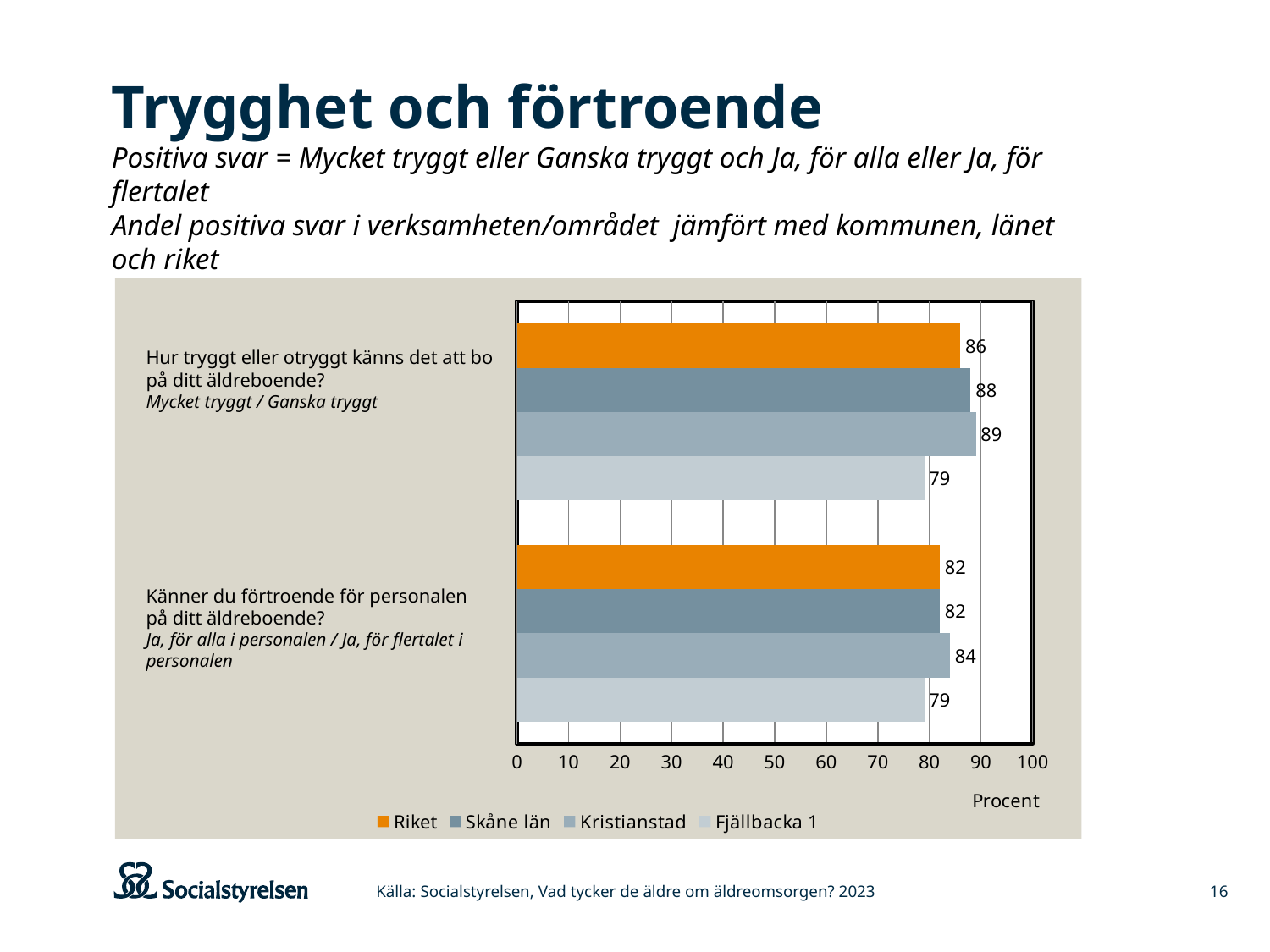
How many series does the legend list? 4 What colour are the bars for Riket? Orange What is the value for Fjällbacka 1 on the question "Känner du förtroende för personalen på ditt äldreboende?"? 79 What kind of chart is shown on the slide? Bar chart What is the value for Kristianstad on the question "Hur tryggt eller otryggt känns det att bo på ditt äldreboende?"? 89 How many question categories are shown on the chart? 2 Which series has the highest value on the question "Hur tryggt eller otryggt känns det att bo på ditt äldreboende?"? Kristianstad What is the value for Skåne län on the question "Hur tryggt eller otryggt känns det att bo på ditt äldreboende?"? 88 Which is larger on the question "Känner du förtroende för personalen på ditt äldreboende?": Kristianstad or Fjällbacka 1? Kristianstad What is the difference between Kristianstad and Fjällbacka 1 on the question "Hur tryggt eller otryggt känns det att bo på ditt äldreboende?"? 10 Which series has the lowest value on the question "Känner du förtroende för personalen på ditt äldreboende?"? Fjällbacka 1 What is the value for Riket on the question "Känner du förtroende för personalen på ditt äldreboende?"? 82